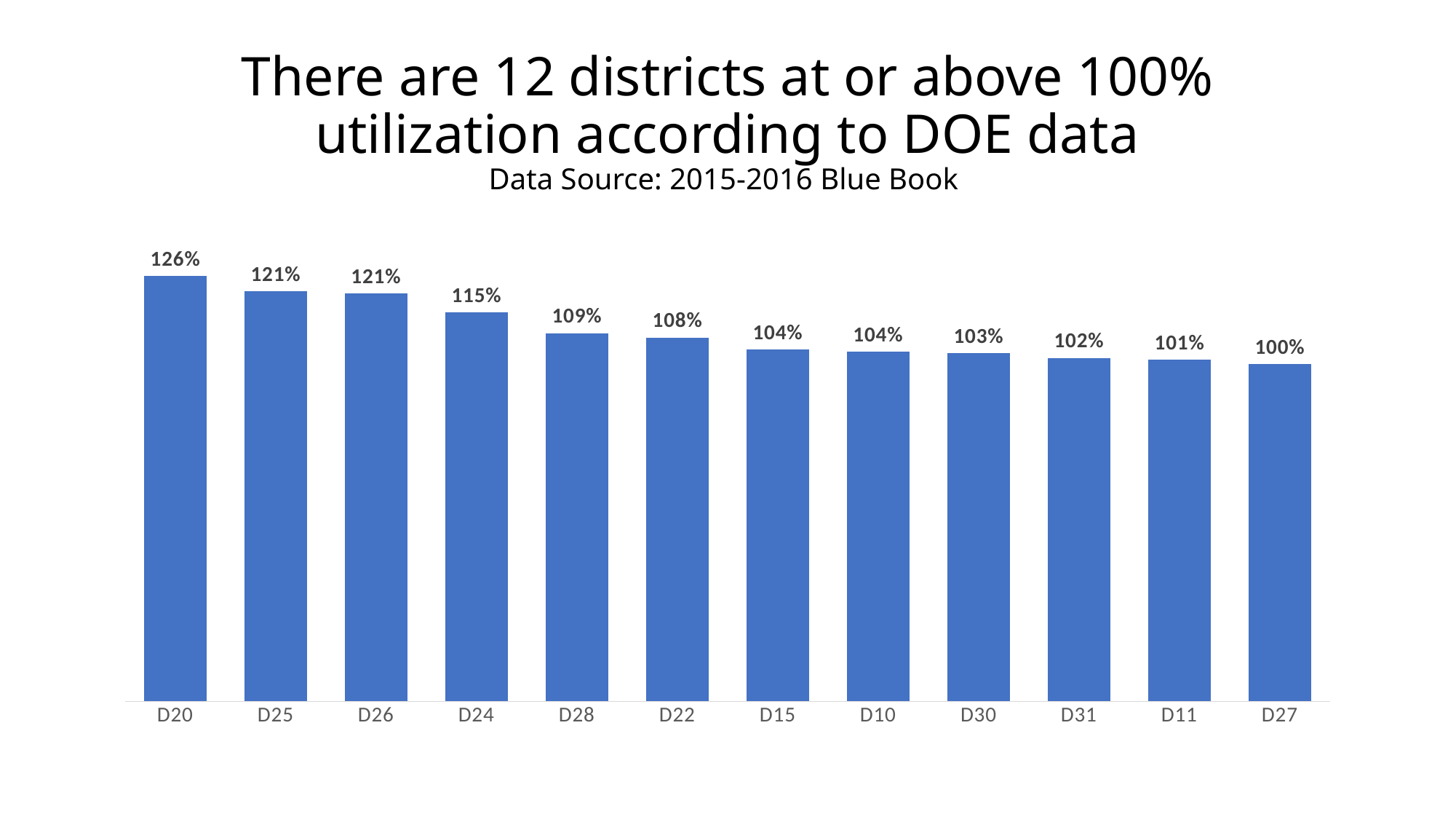
Which district has the highest utilization? D20 What kind of chart is shown on the slide? Bar chart What is the utilization value for D30? 103% Which has a higher utilization, D24 or D15? D24 Do the values rise or fall from left to right along the x axis? Fall What is the difference between the utilization of D20 and D27? 26% How many districts are shown in the chart? 12 What data source is cited below the chart title? 2015-2016 Blue Book Which district has the lowest utilization? D27 What is the difference between the utilization of D28 and D22? 1% What is the utilization value for D24? 115% What is the utilization value for D20? 126%